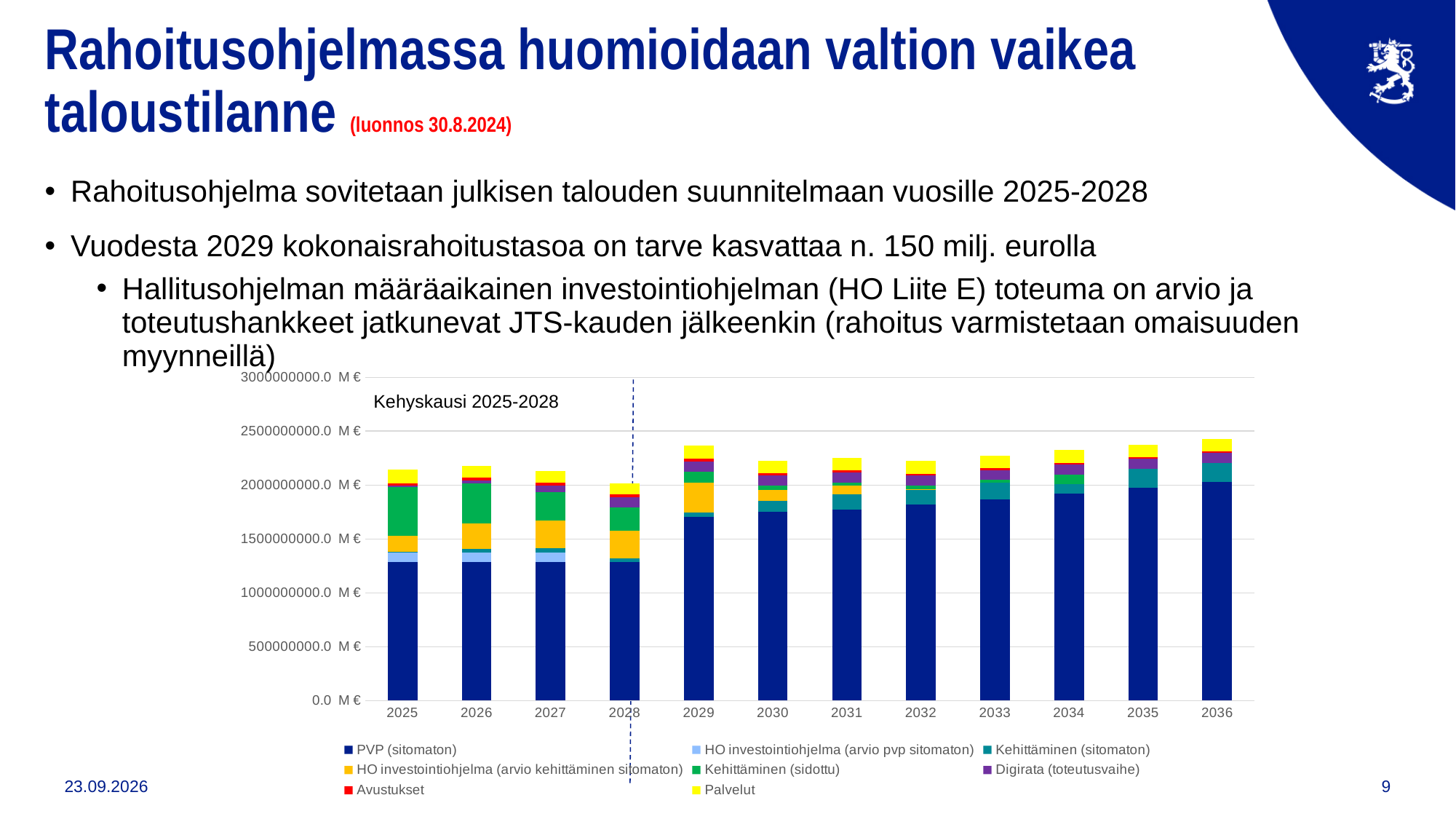
Is the total bar for 2028 greater or less than 2500000000.0 M €? less Is the total bar for 2036 greater or less than 2000000000.0 M €? greater Is the PVP (sitomaton) value for 2025 greater or less than 1500000000.0 M €? less Does the PVP (sitomaton) series rise or fall from 2029 to 2036? rise What kind of chart is shown on the slide? Stacked bar chart What period does the annotation inside the chart label? Kehyskausi 2025-2028 Which total bar is larger, 2029 or 2030? 2029 Which year has the lowest total bar in the chart? 2028 How many years are shown on the x axis of the chart? 12 Which colour represents the Palvelut series in the legend? Yellow How many series does the chart legend list? 8